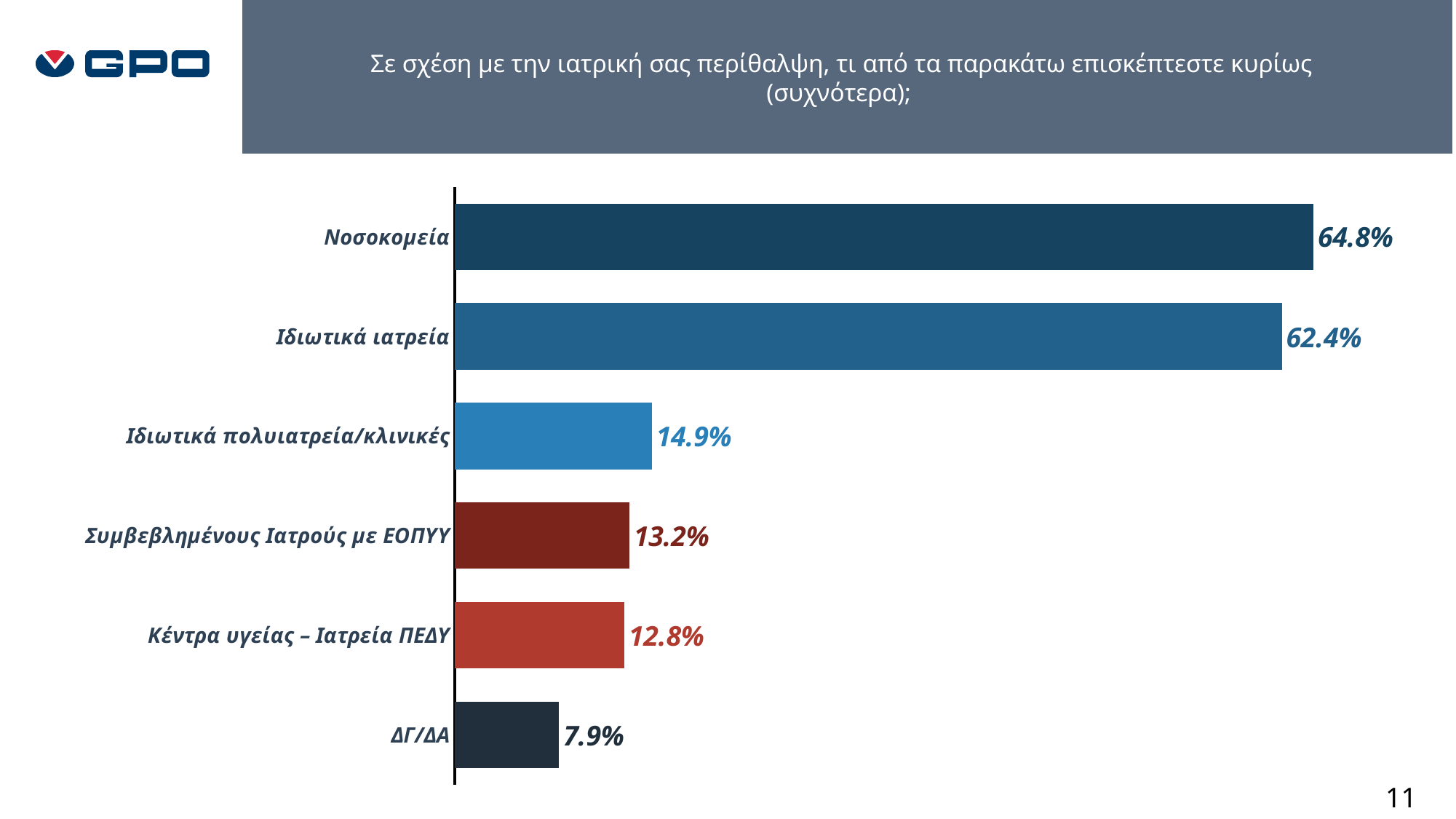
How many categories are shown in the chart? 6 What is the value for Ιδιωτικά πολυιατρεία/κλινικές? 14.9% What is the difference between the values for Νοσοκομεία and Ιδιωτικά ιατρεία? 2.4% Which category has the lowest value? ΔΓ/ΔΑ What kind of chart is shown on the slide? Bar chart Which is larger, the value for Ιδιωτικά ιατρεία or the value for Ιδιωτικά πολυιατρεία/κλινικές? Ιδιωτικά ιατρεία What is the value for Νοσοκομεία? 64.8% What is the value for ΔΓ/ΔΑ? 7.9% What is the difference between the values for Ιδιωτικά πολυιατρεία/κλινικές and Κέντρα υγείας – Ιατρεία ΠΕΔΥ? 2.1% Which category has the highest value? Νοσοκομεία What is the value for Συμβεβλημένους Ιατρούς με ΕΟΠΥΥ? 13.2% What is the value for Ιδιωτικά ιατρεία? 62.4%